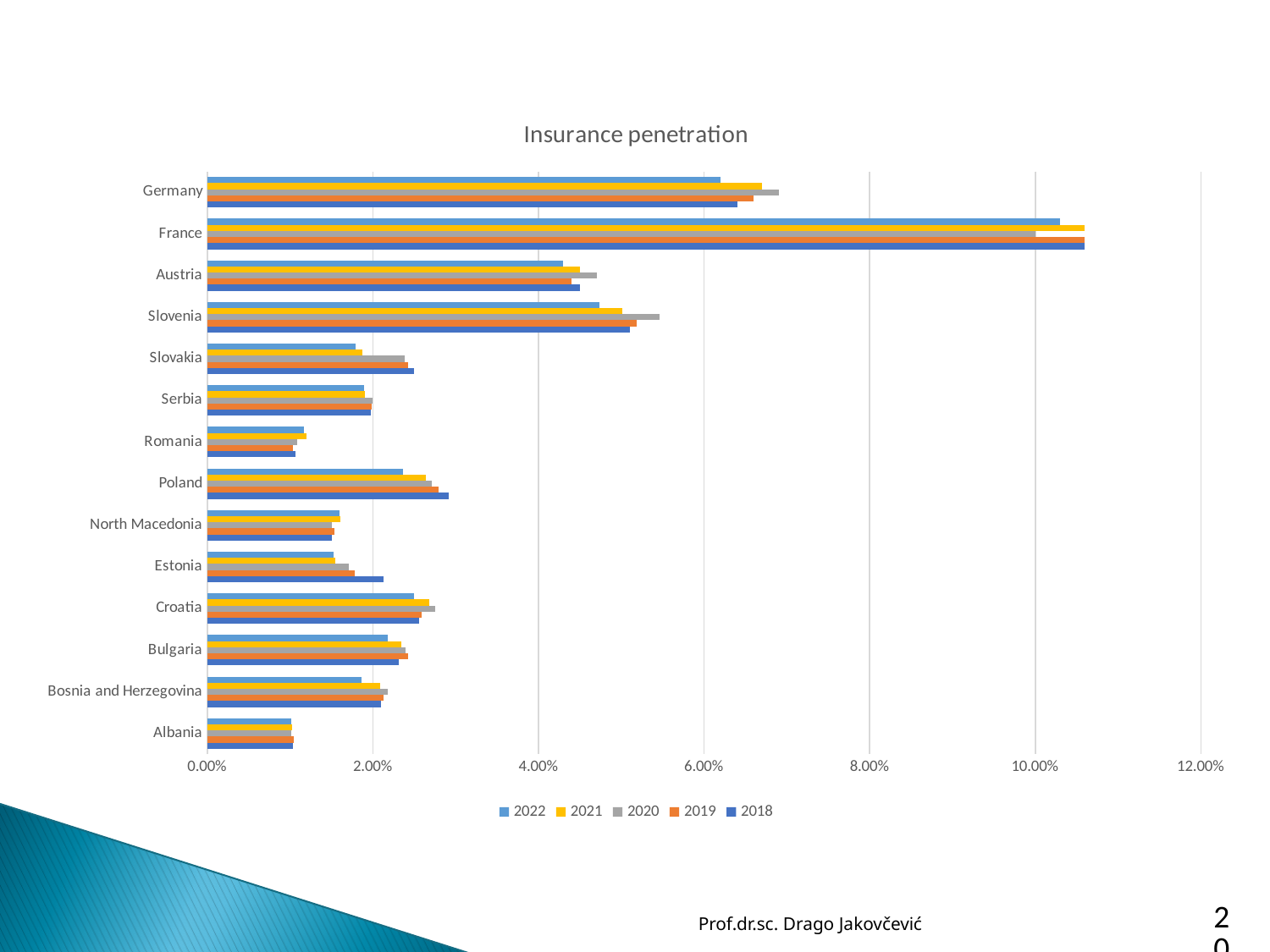
Which country has the lowest insurance penetration on the chart? Albania Which country has the highest insurance penetration on the chart? France What kind of chart is shown on the slide? Bar chart Is the 2020 value for Slovenia greater or less than 6.00%? less What is the title of the chart? Insurance penetration Which has the larger 2022 value, Poland or Romania? Poland Which has the larger 2022 value, Germany or Austria? Germany Is the 2018 value for Poland greater or less than 2.00%? greater How many countries are listed on the chart's vertical axis? 14 How many series does the legend list? 5 Is the 2021 value for France greater or less than 10.00%? greater